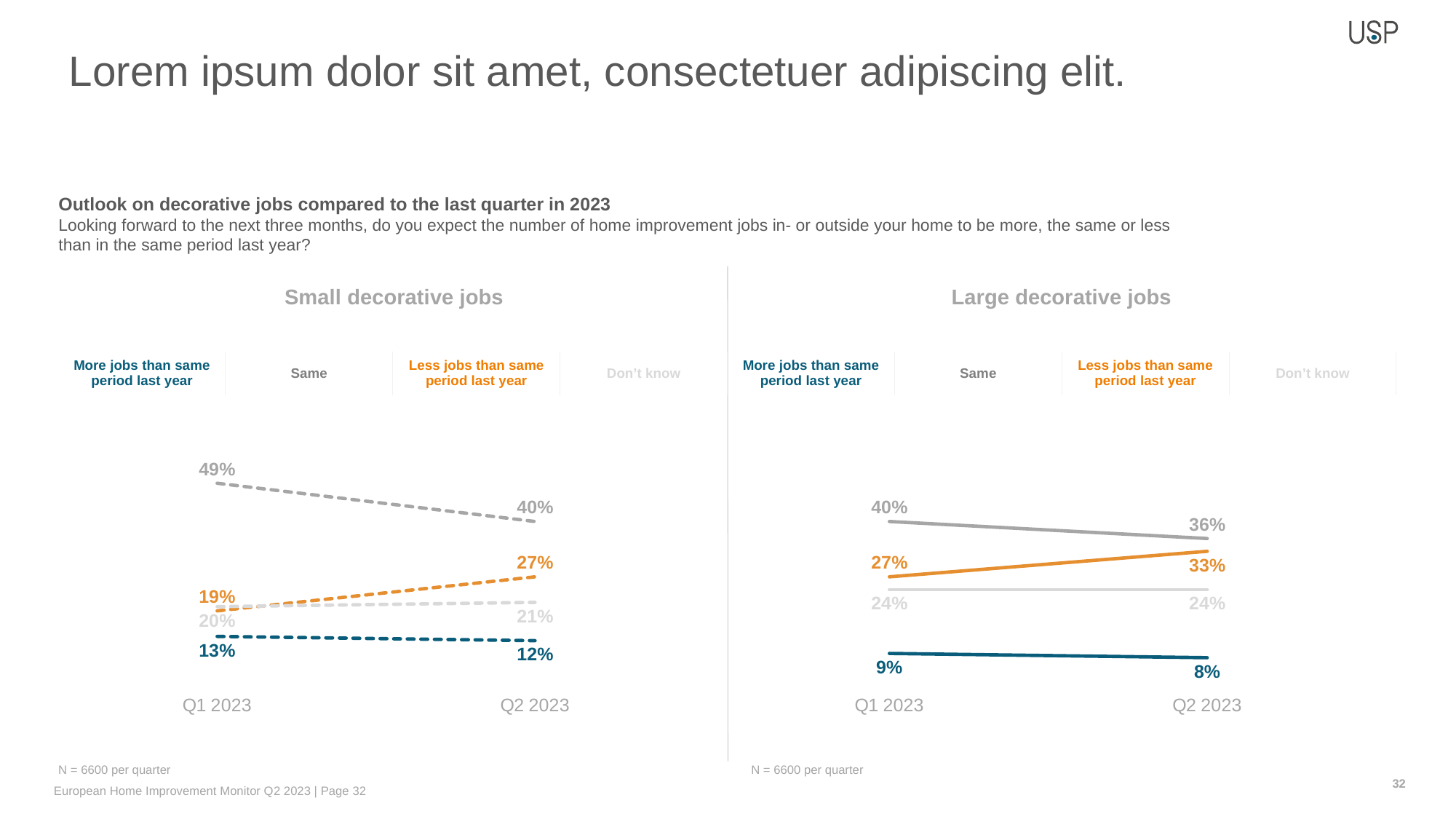
In the Small decorative jobs chart, what is the value for Same in Q1 2023? 49% In the Small decorative jobs chart, does the Less jobs than same period last year series rise or fall from Q1 2023 to Q2 2023? rise In the Large decorative jobs chart, what is the value for Don't know in Q1 2023? 24% In the Small decorative jobs chart, by how many percentage points did Same fall from Q1 2023 to Q2 2023? 9 In the Large decorative jobs chart, what is the difference between Same and Less jobs than same period last year in Q2 2023? 3% What type of chart is the Small decorative jobs chart? line chart In the Small decorative jobs chart, which series has the highest value in Q2 2023? Same In the Large decorative jobs chart, which series has the lowest value in Q1 2023? More jobs than same period last year In the Large decorative jobs chart, what is the value for More jobs than same period last year in Q2 2023? 8% In the Large decorative jobs chart, which is larger in Q1 2023: Same or Less jobs than same period last year? Same How many series does the legend of the Large decorative jobs chart list? 4 In the Small decorative jobs chart, what is the value for Less jobs than same period last year in Q2 2023? 27%